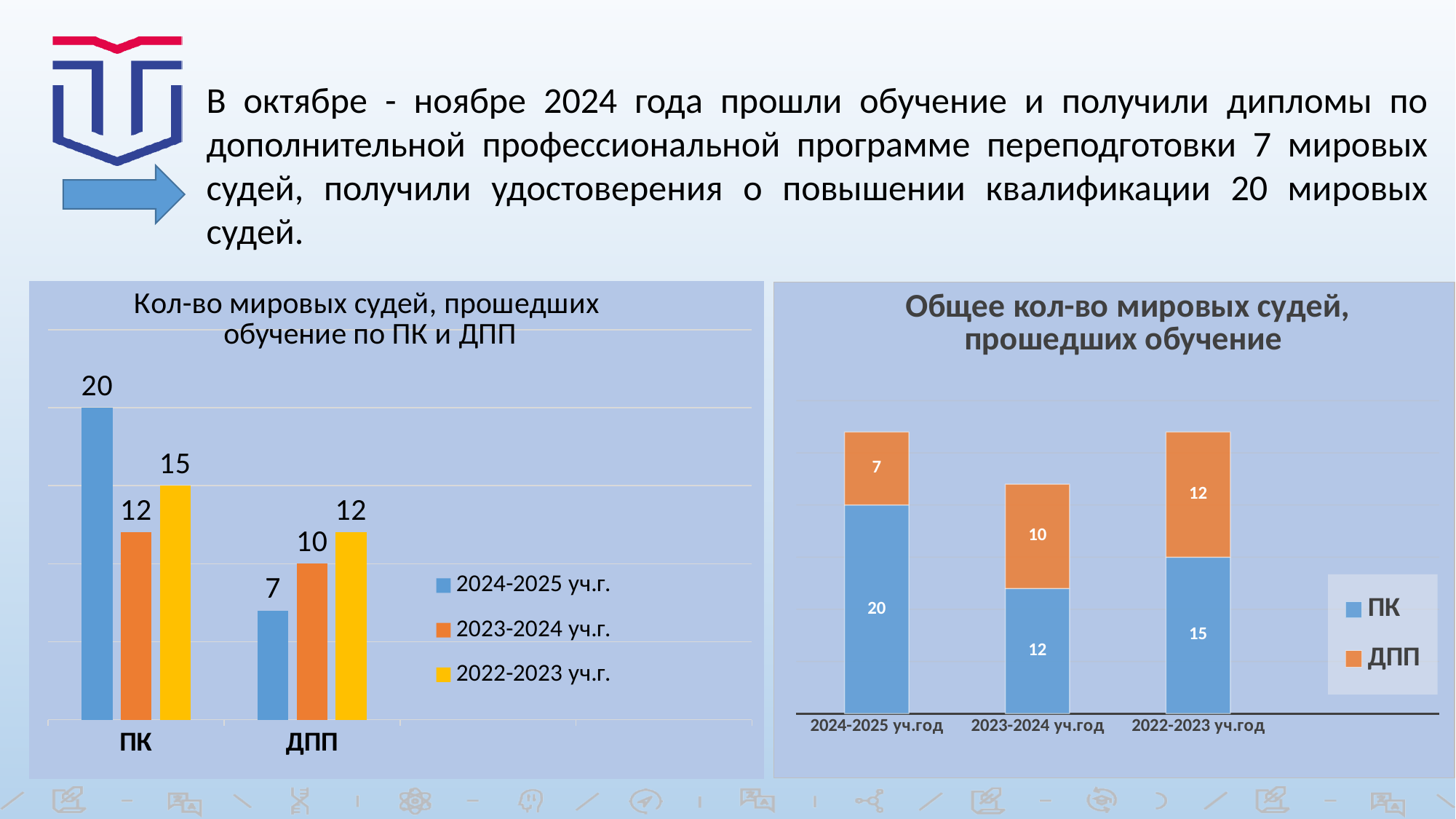
In the left chart 'Кол-во мировых судей, прошедших обучение по ПК и ДПП', what is the difference between the ПК and ДПП values in the 2024-2025 уч.г. series? 13 In the left chart 'Кол-во мировых судей, прошедших обучение по ПК и ДПП', what is the value for ПК in the 2024-2025 уч.г. series? 20 In the left chart 'Кол-во мировых судей, прошедших обучение по ПК и ДПП', what is the value for ДПП in the 2023-2024 уч.г. series? 10 In the right chart 'Общее кол-во мировых судей, прошедших обучение', how many categories are shown on the x axis? 3 In the left chart 'Кол-во мировых судей, прошедших обучение по ПК и ДПП', how many series does the legend list? 3 In the right chart 'Общее кол-во мировых судей, прошедших обучение', what is the total of the stacked bar for 2023-2024 уч.год? 22 In the right chart 'Общее кол-во мировых судей, прошедших обучение', which colour represents ДПП in the legend? orange In the right chart 'Общее кол-во мировых судей, прошедших обучение', what is the ДПП value for 2022-2023 уч.год? 12 What kind of chart is the left chart 'Кол-во мировых судей, прошедших обучение по ПК и ДПП'? bar chart In the left chart 'Кол-во мировых судей, прошедших обучение по ПК и ДПП', which series has the highest value for ПК? 2024-2025 уч.г. In the left chart 'Кол-во мировых судей, прошедших обучение по ПК и ДПП', which series has the lowest value for ДПП? 2024-2025 уч.г. In the right chart 'Общее кол-во мировых судей, прошедших обучение', is the ПК value for 2024-2025 уч.год larger or smaller than the ПК value for 2022-2023 уч.год? larger